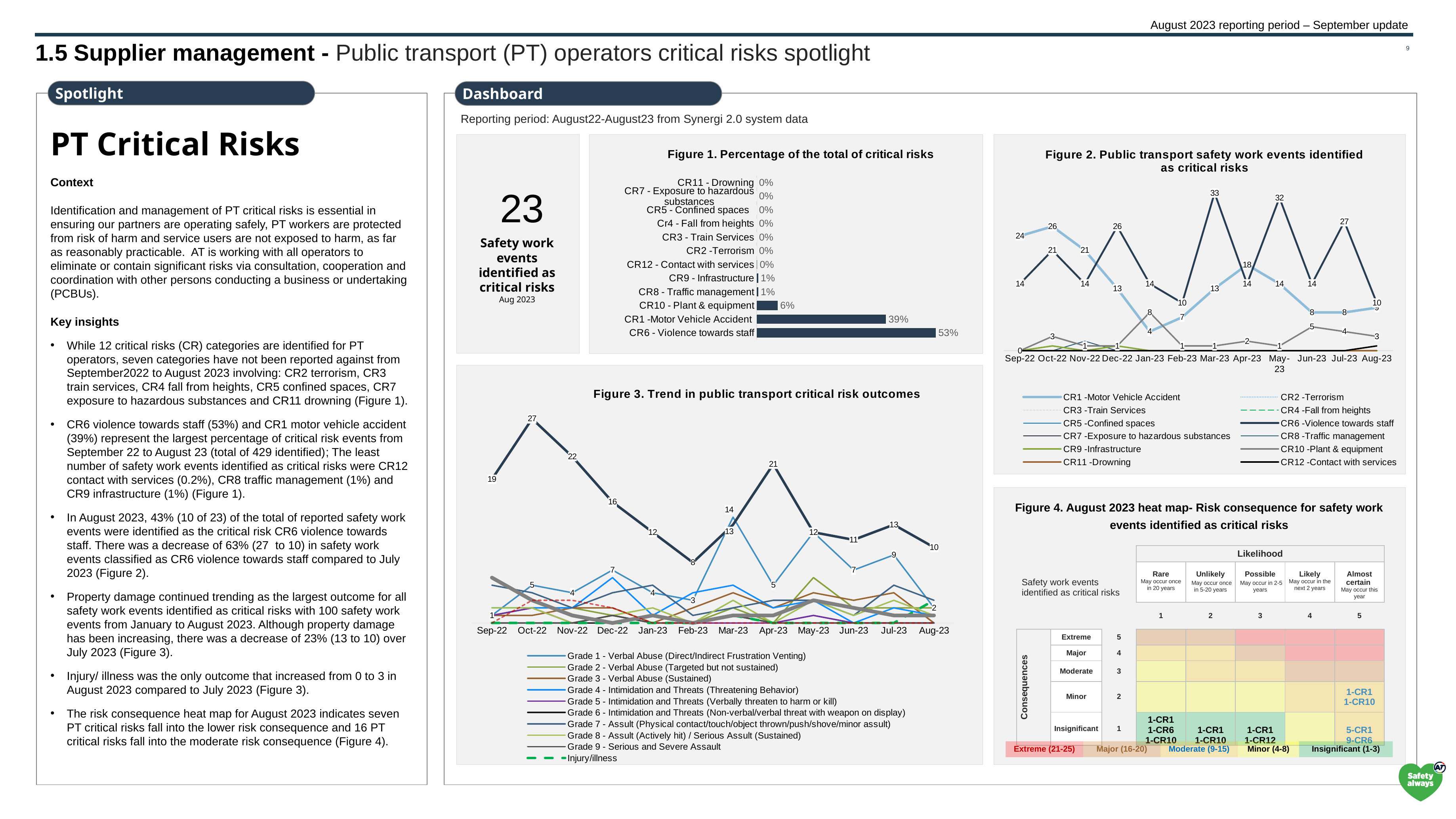
In Figure 1, what percentage is shown for CR10 - Plant & equipment? 6% In Figure 2, what is the value for CR6 - Violence towards staff in Aug-23? 10 In Figure 1, which critical risk category has the highest percentage? CR6 - Violence towards staff In Figure 2, in which month does CR6 - Violence towards staff reach its highest value? Mar-23 In Figure 1, what percentage is shown for CR6 - Violence towards staff? 53% In Figure 1, what percentage is shown for CR1 - Motor Vehicle Accident? 39% How many critical risk categories are listed in Figure 1? 12 How many series does the legend of Figure 2 list? 12 What type of chart is Figure 1? Bar chart In Figure 1, what is the difference in percentage points between CR6 - Violence towards staff and CR1 - Motor Vehicle Accident? 14% In Figure 2, what is the value for CR6 - Violence towards staff in Mar-23? 33 How many series does the legend of Figure 3 list? 10